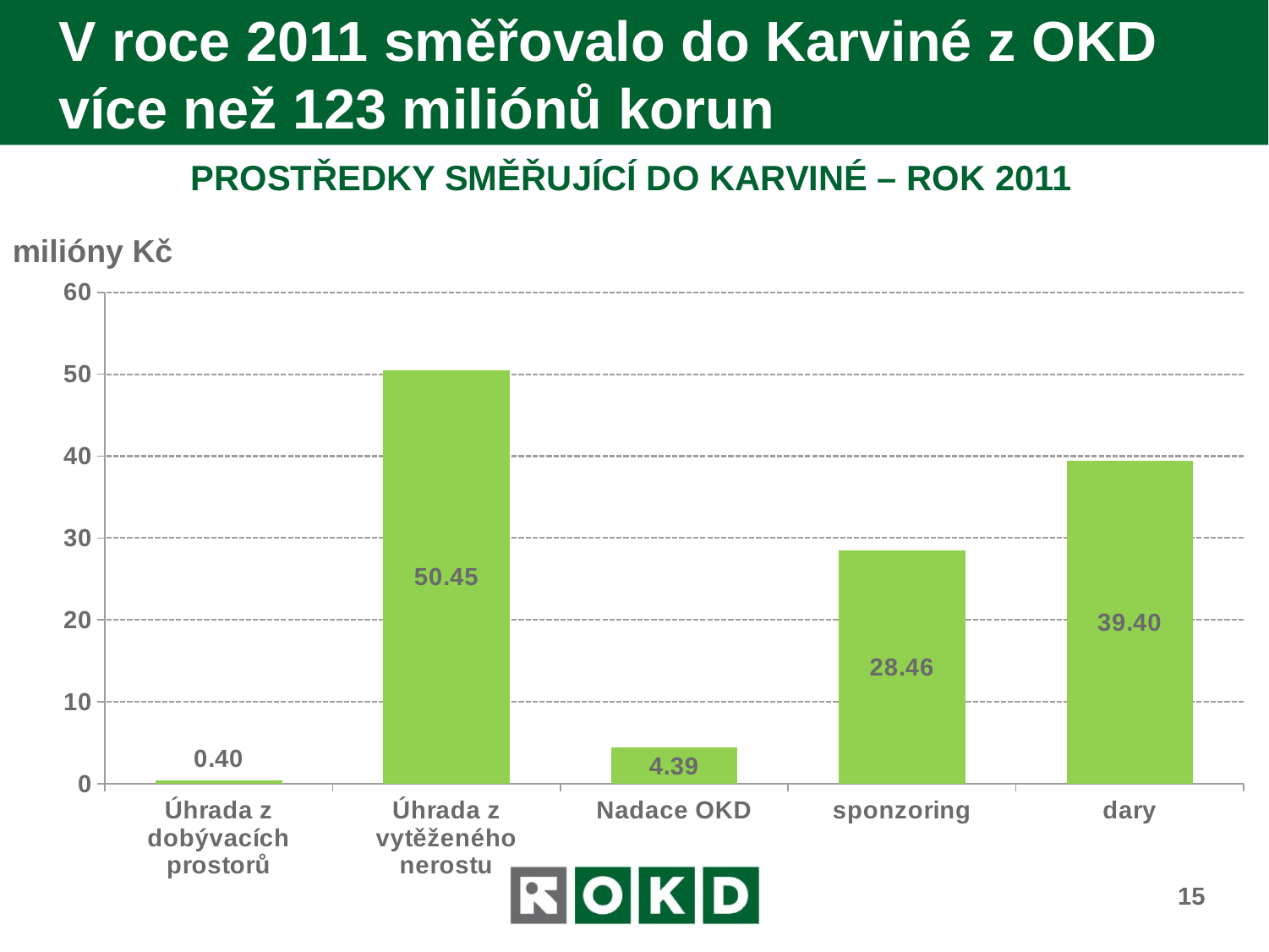
What unit is shown on the chart's axis label? milióny Kč What is the value for Nadace OKD? 4.39 Which is larger, the value for sponzoring or the value for dary? dary What is the value for Úhrada z dobývacích prostorů? 0.40 How many categories are shown in the chart? 5 What kind of chart is shown on the slide? bar chart Which category has the lowest value? Úhrada z dobývacích prostorů What is the difference between the values for Úhrada z vytěženého nerostu and dary? 11.05 Is the value for sponzoring greater or less than 30? less Which category has the highest value? Úhrada z vytěženého nerostu What is the value for sponzoring? 28.46 What is the value for dary? 39.40